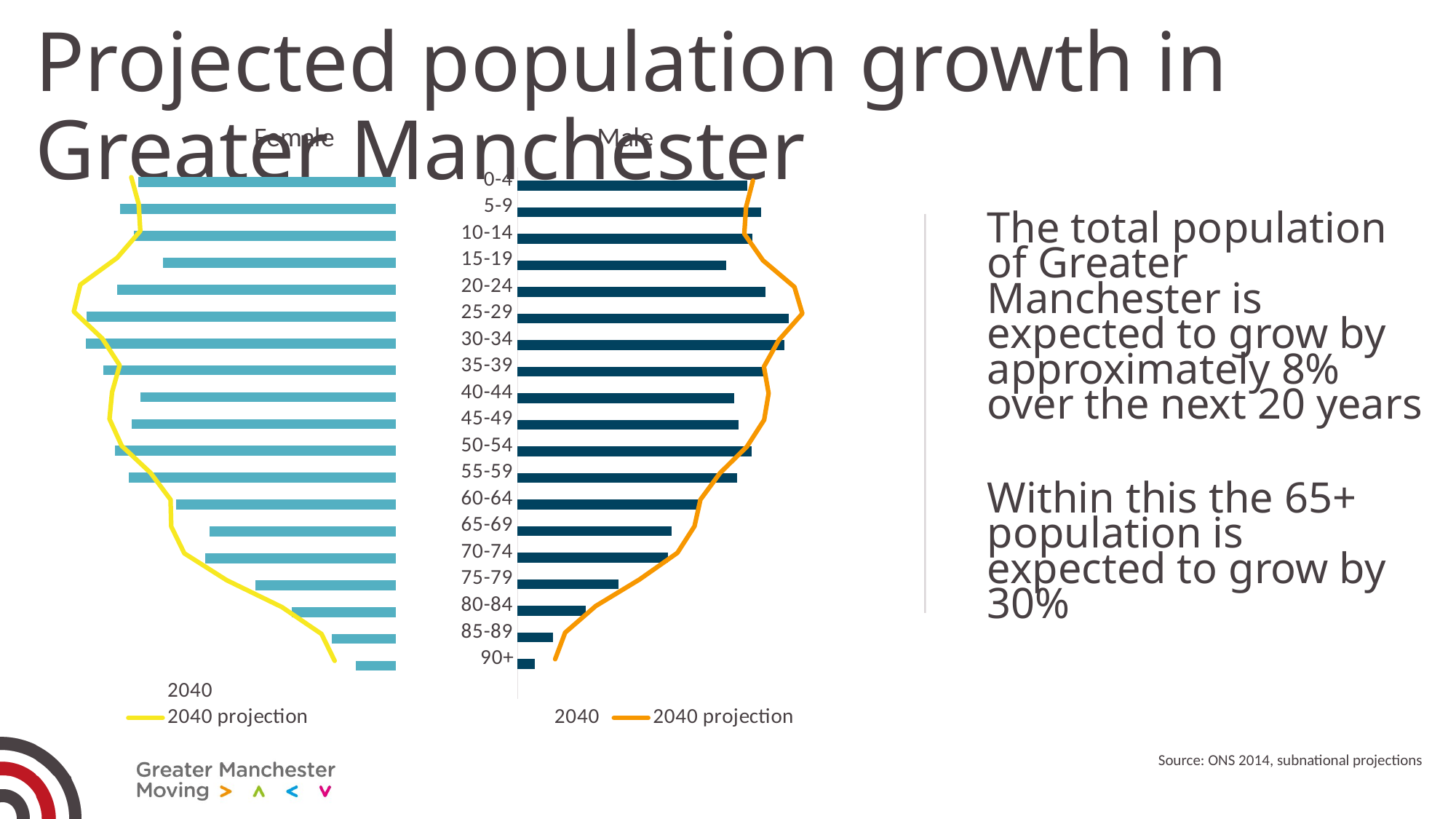
In the Male chart, which 2040 bar is longer: 15-19 or 20-24? 20-24 In the Female chart, which 2040 bar is longer: 80-84 or 85-89? 80-84 In the Male chart, which age group has the shortest 2040 bar? 90+ In the Male chart, which age group has the longest 2040 bar? 25-29 In the Male chart, do the 2040 bars get longer or shorter going from 60-64 down to 90+? shorter What kind of chart is the Male chart on the slide? bar chart What colour is the 2040 projection line in the Male chart? orange What is the title of the chart on the left of the slide? Female In the Female chart, which age group has the shortest 2040 bar? 90+ In the Male chart, which 2040 bar is longer: 60-64 or 65-69? 60-64 How many age-group categories does the Male chart show? 19 How many series does the legend of the Female chart list? 2